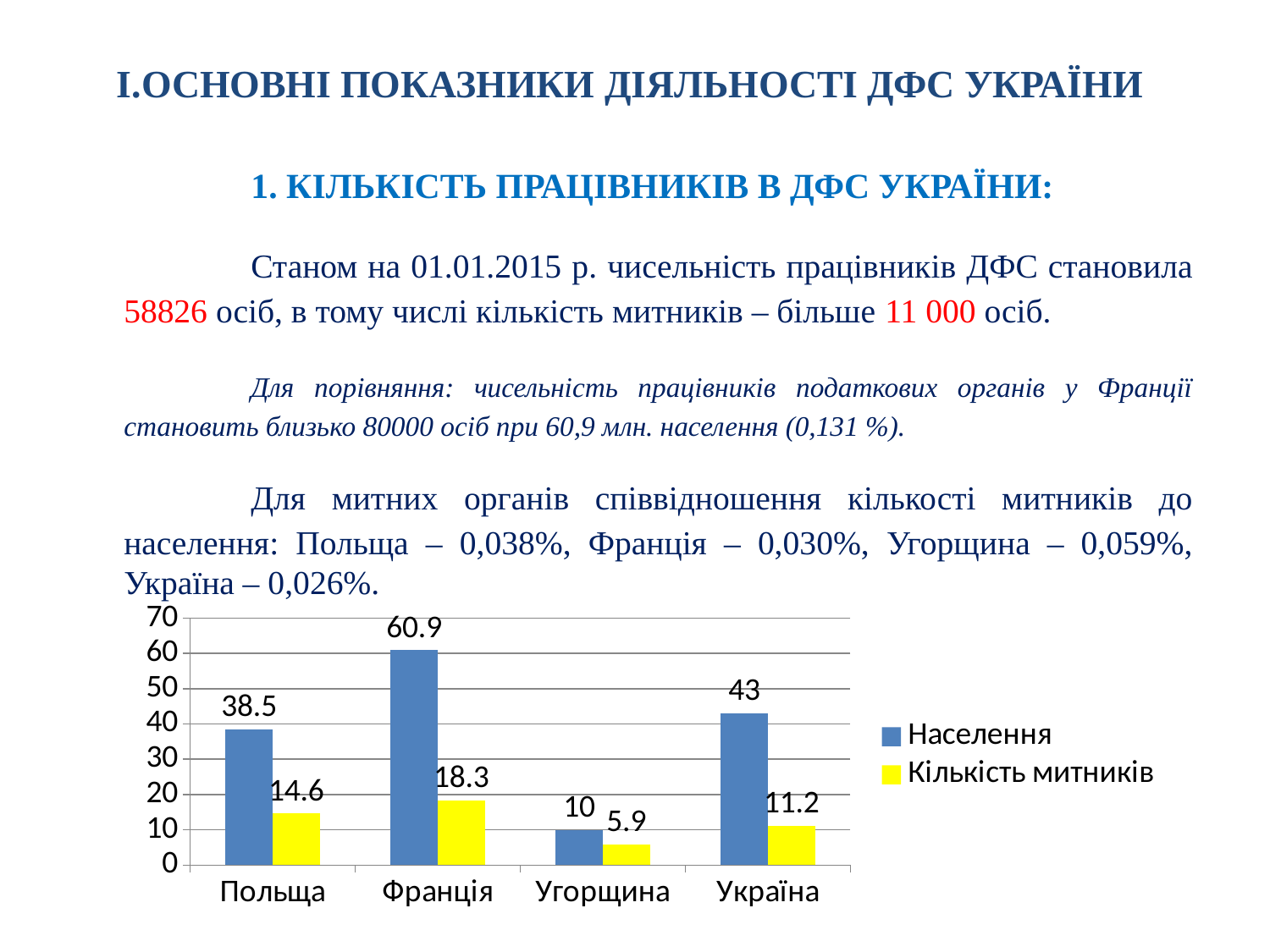
What is the value of Кількість митників for Угорщина? 5.9 How many categories are shown on the x axis of the chart? 4 What kind of chart is shown on the slide? bar chart How many series does the chart legend list? 2 Which category has the highest Населення value? Франція What is the value of Населення for Україна? 43 Which is larger: Кількість митників for Франція or for Україна? Франція Which category has the lowest Кількість митників value? Угорщина What is the value of Населення for Франція? 60.9 What is the difference between the Населення values for Франція and Польща? 22.4 What is the value of Кількість митників for Польща? 14.6 What colour are the Кількість митників bars in the chart? yellow